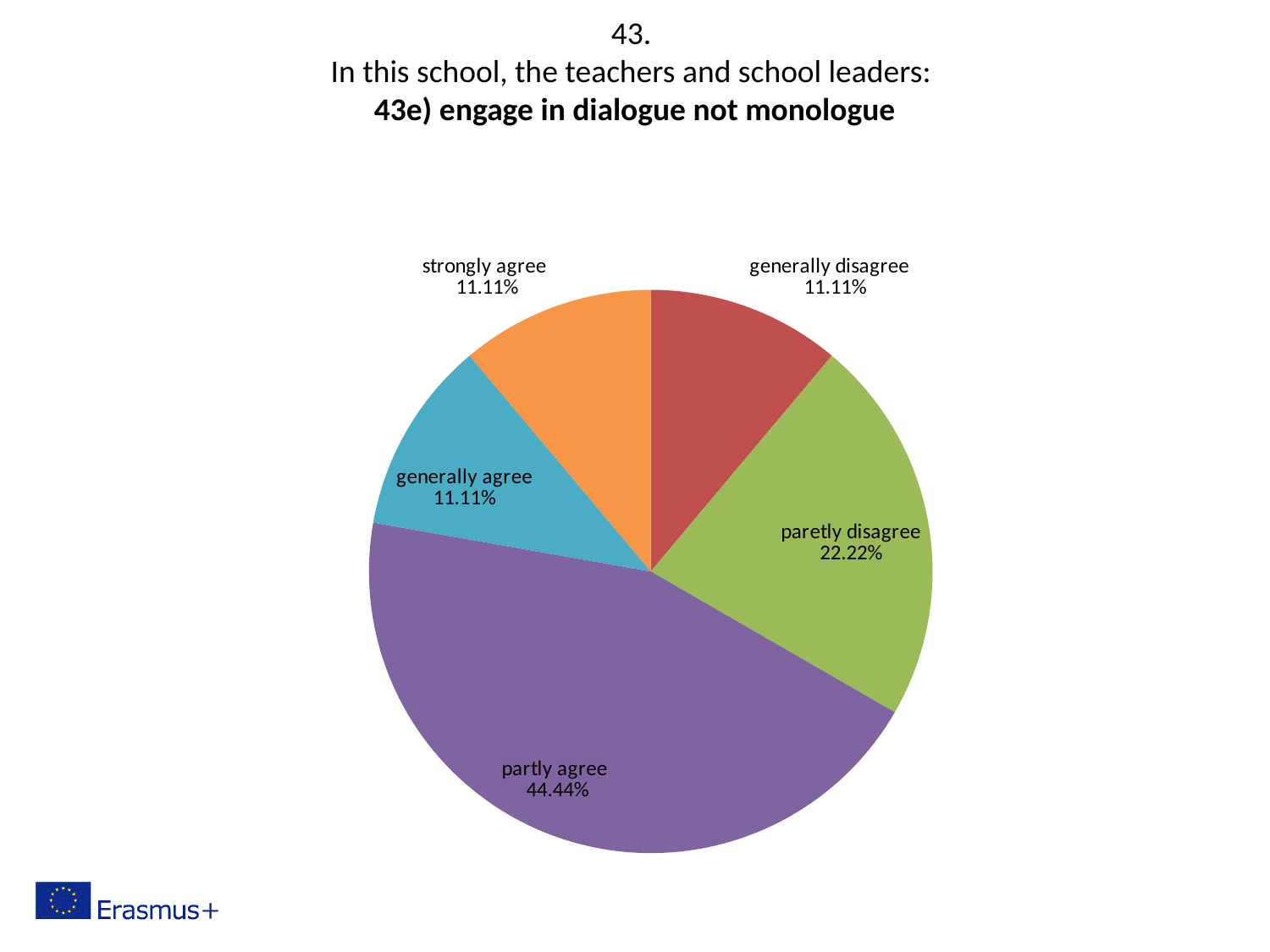
What percentage of respondents chose 'partly agree'? 44.44% Which is larger, the share for 'paretly disagree' or the share for 'generally agree'? paretly disagree What percentage of respondents chose 'paretly disagree'? 22.22% What is the bold part of the slide title? 43e) engage in dialogue not monologue What percentage of respondents chose 'generally disagree'? 11.11% What is the difference in percentage points between 'partly agree' and 'paretly disagree'? 22.22 What kind of chart is shown on the slide? pie chart How many slices does the pie chart have? 5 What is the combined share of 'strongly agree' and 'generally agree'? 22.22% What percentage of respondents chose 'strongly agree'? 11.11% Which response category is shown in purple? partly agree Which response category has the largest share of the pie? partly agree